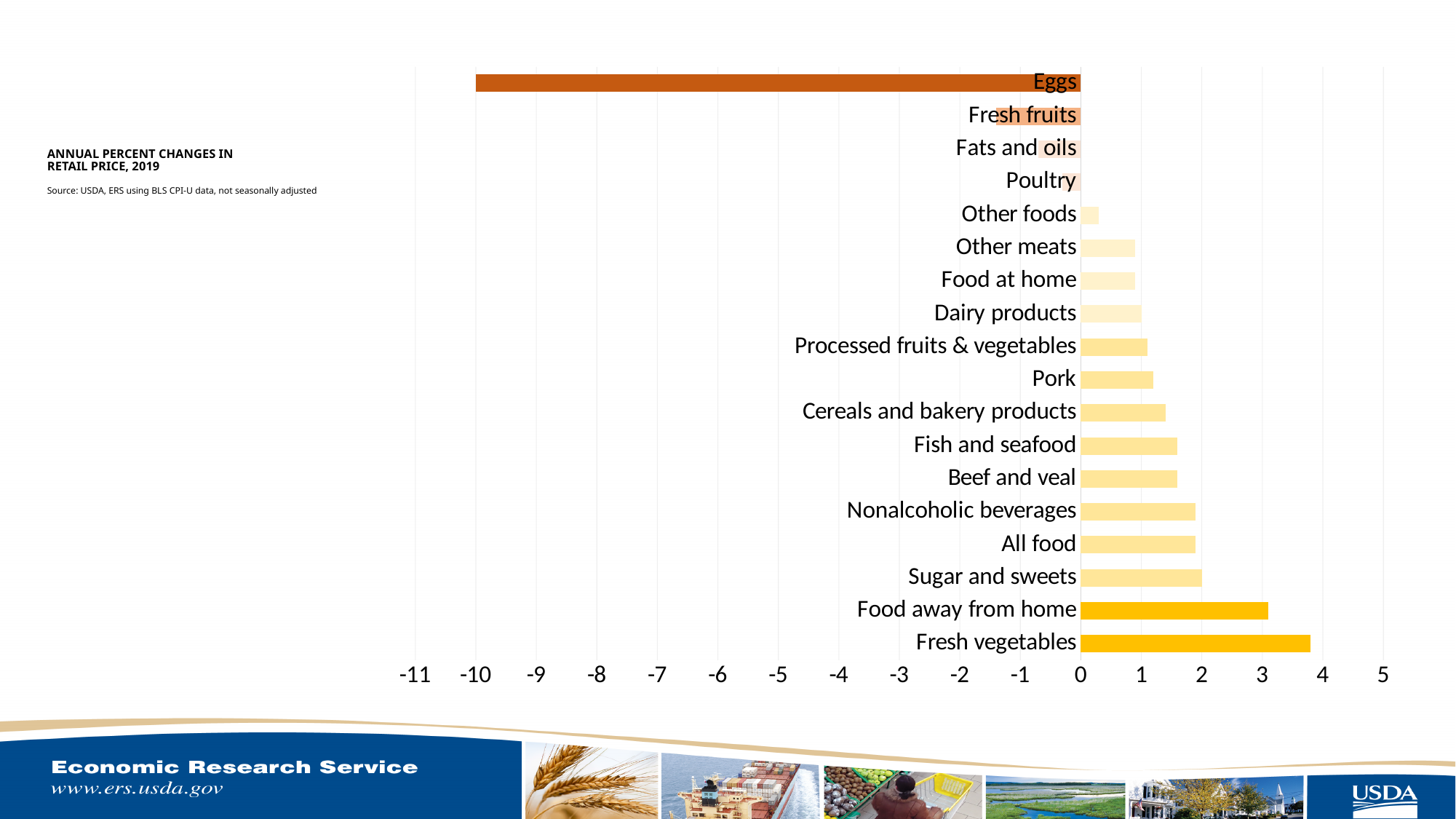
Which is larger, the value for Food away from home or the value for Sugar and sweets? Food away from home Is the value for Fish and seafood greater or less than 1? greater How many food categories are plotted in the chart? 18 Is the value for Fresh fruits greater or less than 0? less Is the value for Eggs greater or less than -5? less What kind of chart is shown on the slide? Bar chart Which category has the highest annual percent change in retail price? Fresh vegetables Which category has the lowest annual percent change in retail price? Eggs What is the title of the chart? Annual percent changes in retail price, 2019 Which is larger, the value for Pork or the value for Other foods? Pork